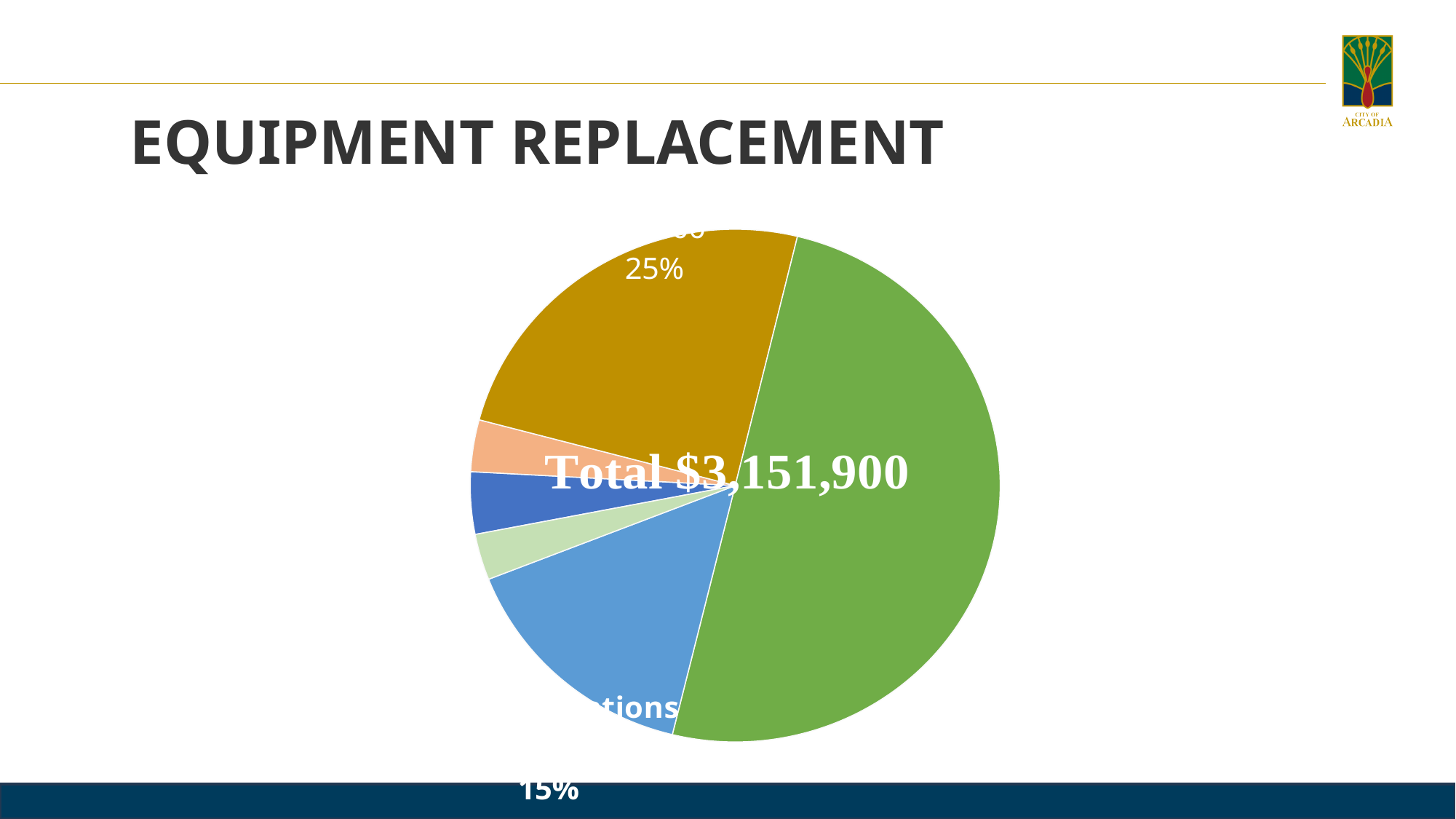
What percentage is printed on the gold slice of the pie chart? 25% What kind of chart is shown on the slide? pie chart What is the title of the slide containing the pie chart? EQUIPMENT REPLACEMENT How many slices does the pie chart have? 6 Which colour slice is the largest in the pie chart? green What total amount is printed in the centre of the pie chart? Total $3,151,900 Is the green slice of the pie chart larger or smaller than the gold slice? larger